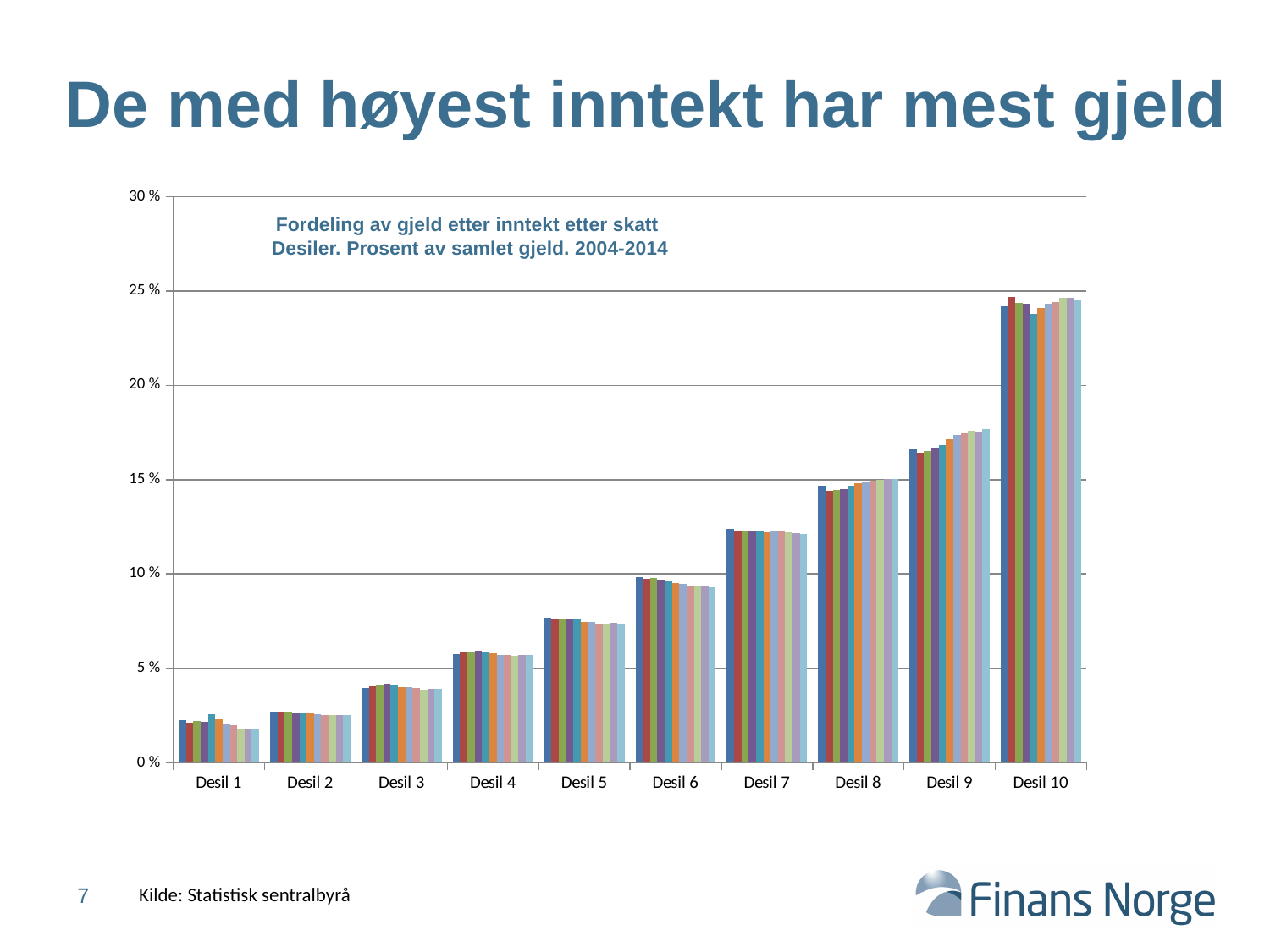
Which decile has the lowest share of total debt? Desil 1 Do the values rise or fall as you move from Desil 1 to Desil 10? rise Which decile has the highest share of total debt? Desil 10 Is the value for Desil 3 greater or less than 5%? less Is the value for Desil 10 greater or less than 20%? greater What kind of chart is shown on the slide? bar chart How many deciles (categories) are shown on the x axis? 10 Is the value for Desil 7 greater or less than 10%? greater What period does the chart title say the data covers? 2004-2014 Which has a larger share of total debt, Desil 5 or Desil 8? Desil 8